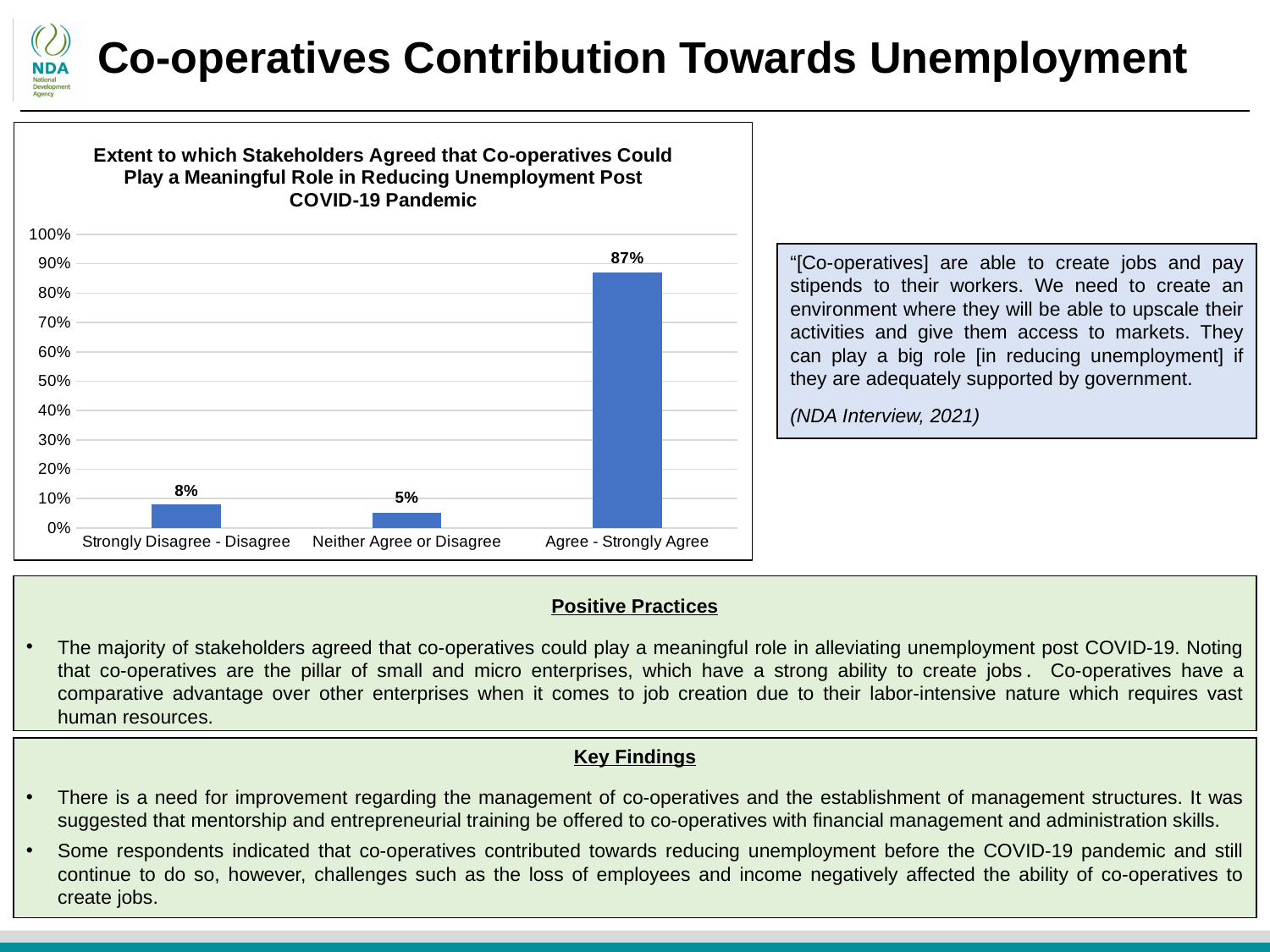
Which category has the lowest value? Neither Agree or Disagree What percentage of stakeholders fell into the 'Agree - Strongly Agree' category? 87% What kind of chart is shown on the slide? Bar chart What percentage of stakeholders fell into the 'Neither Agree or Disagree' category? 5% What is the difference between the 'Strongly Disagree - Disagree' and 'Neither Agree or Disagree' values? 3% Is the value for 'Agree - Strongly Agree' greater or less than 80%? greater What is the difference between the 'Agree - Strongly Agree' and 'Strongly Disagree - Disagree' values? 79% Which is larger, the value for 'Strongly Disagree - Disagree' or for 'Neither Agree or Disagree'? Strongly Disagree - Disagree What percentage of stakeholders fell into the 'Strongly Disagree - Disagree' category? 8% How many categories are shown on the x axis of the chart? 3 What is the title of the chart? Extent to which Stakeholders Agreed that Co-operatives Could Play a Meaningful Role in Reducing Unemployment Post COVID-19 Pandemic Which category has the highest value? Agree - Strongly Agree